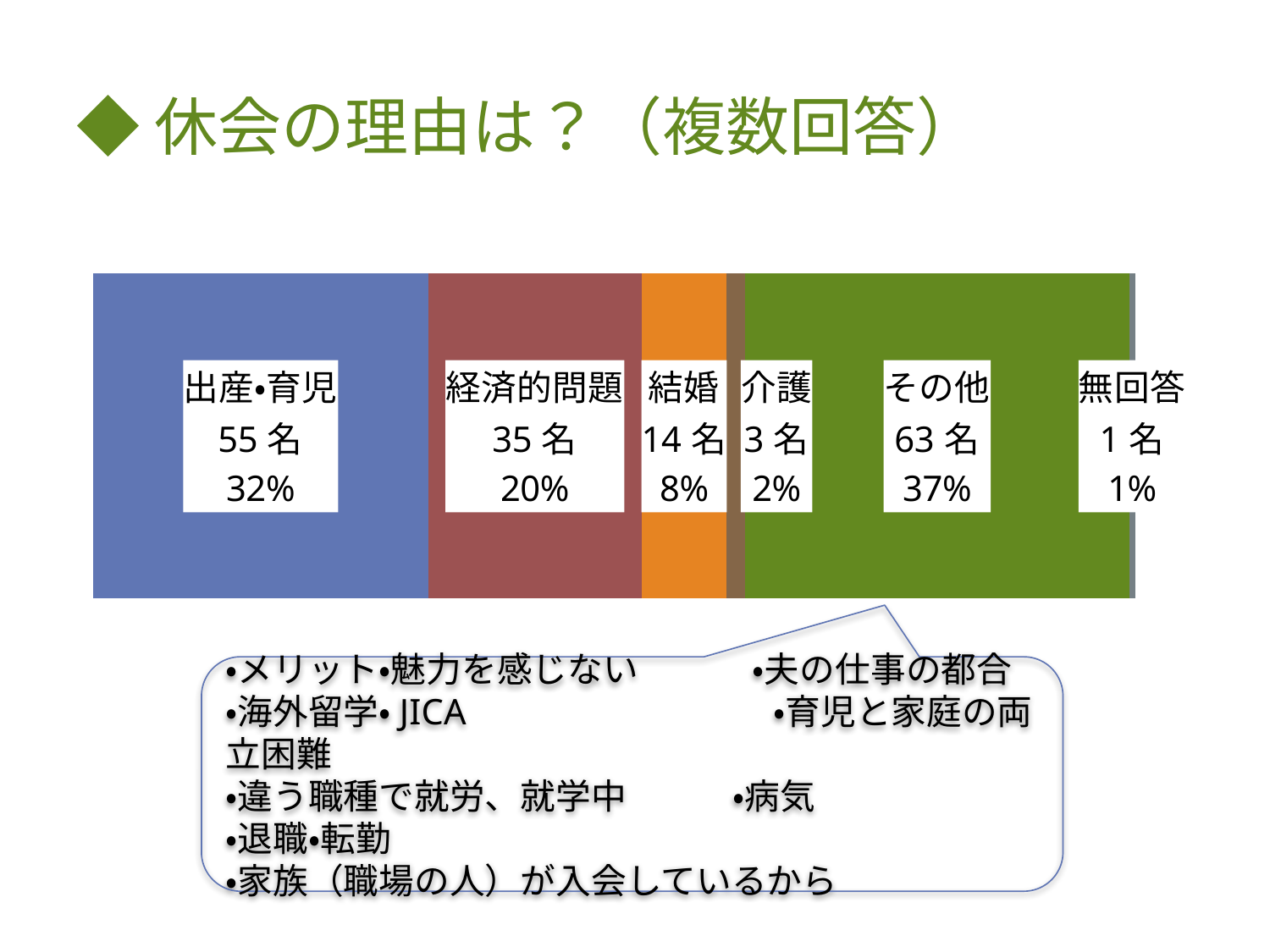
What is the total number of respondents across all segments of the bar? 171名 What is the title of the slide? 休会の理由は？（複数回答） How many respondents gave 出産・育児 as a reason for 休会? 55名 What percentage is shown for 経済的問題? 20% What kind of chart is shown on the slide? Stacked bar chart Which has more respondents, 経済的問題 or 結婚? 経済的問題 How many categories are shown in the bar? 6 Which category has the largest number of respondents? その他 What is the difference in respondents between その他 and 出産・育児? 8名 How many respondents cited 結婚? 14名 What percentage is shown for 介護? 2% Which category has the smallest number of respondents? 無回答